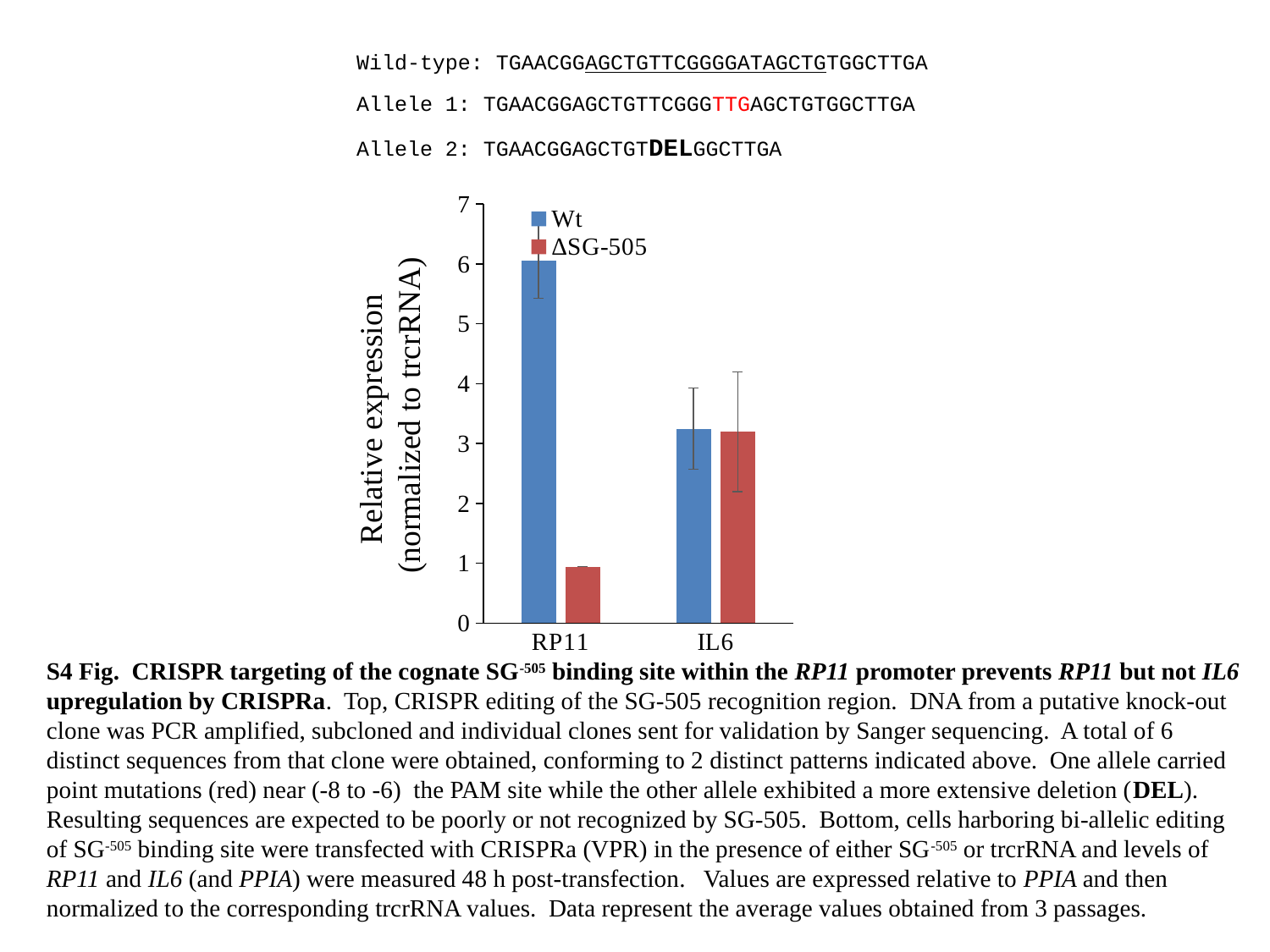
Is the ΔSG-505 value for IL6 greater or less than 5? less Is the ΔSG-505 value for RP11 greater or less than 2? less Is the Wt value for IL6 greater or less than 2? greater How many series does the chart legend list? 2 For RP11, which series has the larger value, Wt or ΔSG-505? Wt Which series and category has the highest bar in the chart? Wt for RP11 Which colour represents the ΔSG-505 series in the chart? Red What kind of chart is shown on the slide? Bar chart Which series and category has the lowest bar in the chart? ΔSG-505 for RP11 How many categories are shown on the x axis of the chart? 2 What is the label of the y axis of the chart? Relative expression (normalized to trcrRNA)